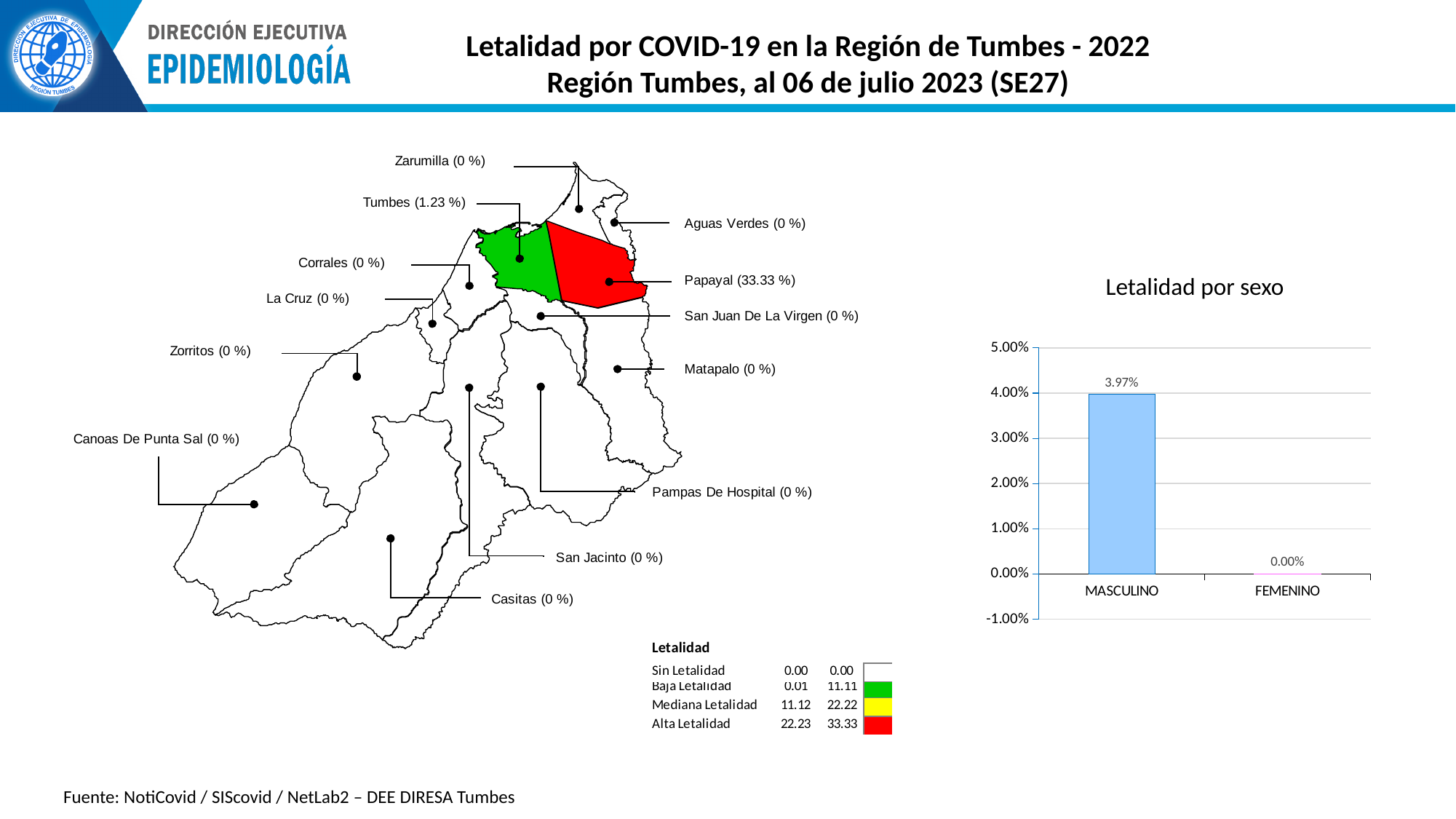
On the map of the Tumbes region, what is the lethality value shown for Tumbes? 1.23 % What is the title of the chart on the right side of the slide? Letalidad por sexo What kind of chart is 'Letalidad por sexo'? bar chart In the 'Letalidad por sexo' chart, what is the difference between the MASCULINO and FEMENINO values? 3.97% In the 'Letalidad por sexo' chart, what is the value for FEMENINO? 0.00% In the 'Letalidad por sexo' chart, what is the value for MASCULINO? 3.97% On the map of the Tumbes region, what is the lethality value shown for Papayal? 33.33 % In the 'Letalidad por sexo' chart, is the value for MASCULINO greater or less than 3.00%? greater In the 'Letalidad por sexo' chart, which category has the highest value? MASCULINO In the 'Letalidad por sexo' chart, which category has the lowest value? FEMENINO On the map of the Tumbes region, which district has the highest lethality value? Papayal How many categories are shown in the 'Letalidad por sexo' chart? 2